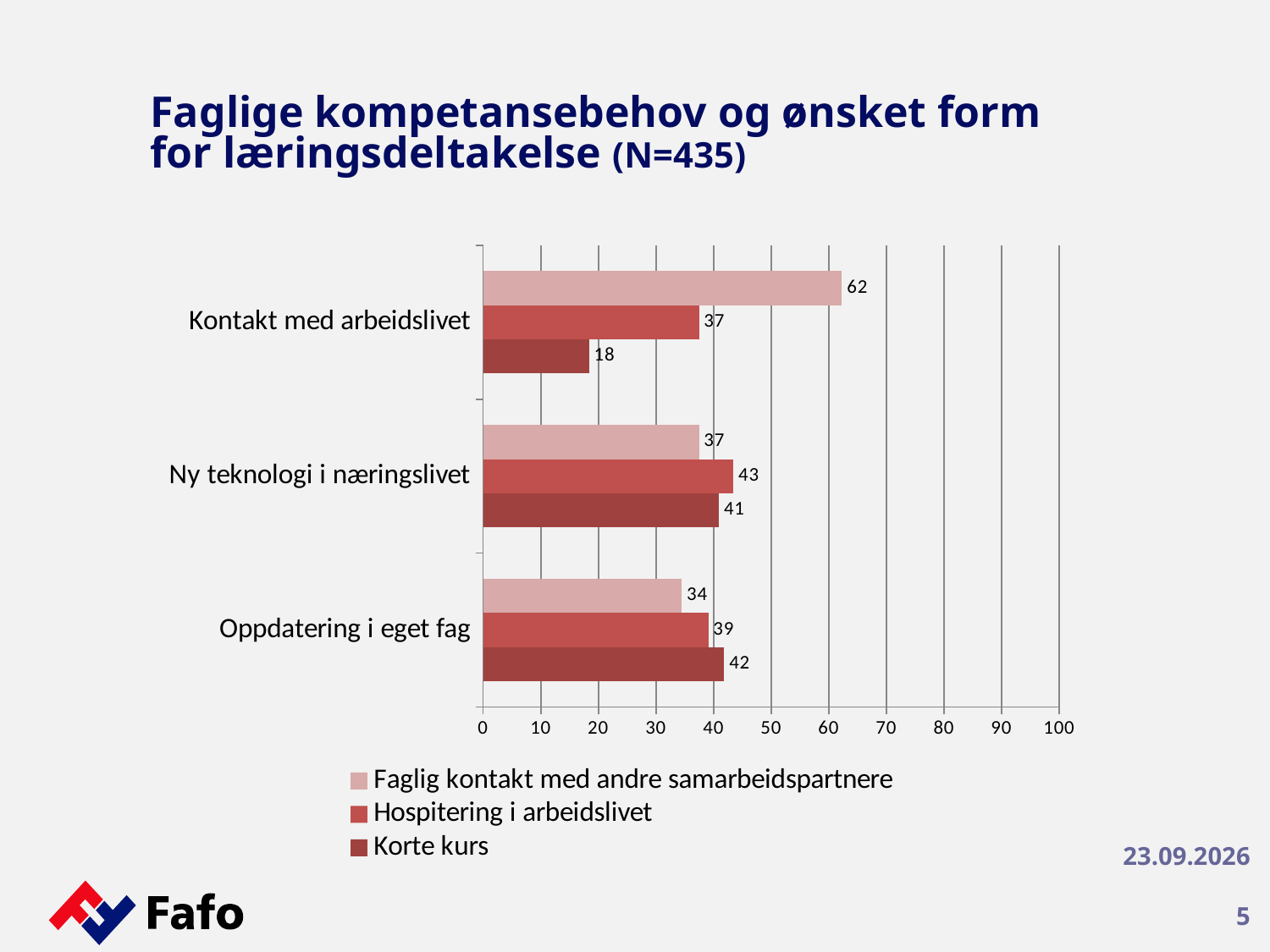
What is the N value given in the slide title? N=435 What is the value for Faglig kontakt med andre samarbeidspartnere for Kontakt med arbeidslivet? 62 Which category has the lowest value for Korte kurs? Kontakt med arbeidslivet What is the value for Korte kurs for Kontakt med arbeidslivet? 18 What kind of chart is shown on the slide? Bar chart How many series does the legend list? 3 What is the value for Korte kurs for Oppdatering i eget fag? 42 What is the value for Hospitering i arbeidslivet for Ny teknologi i næringslivet? 43 What is the difference between the Faglig kontakt med andre samarbeidspartnere value and the Korte kurs value for Kontakt med arbeidslivet? 44 For Oppdatering i eget fag, which is larger: Hospitering i arbeidslivet or Korte kurs? Korte kurs How many categories are shown on the chart? 3 Which category has the highest value for Faglig kontakt med andre samarbeidspartnere? Kontakt med arbeidslivet